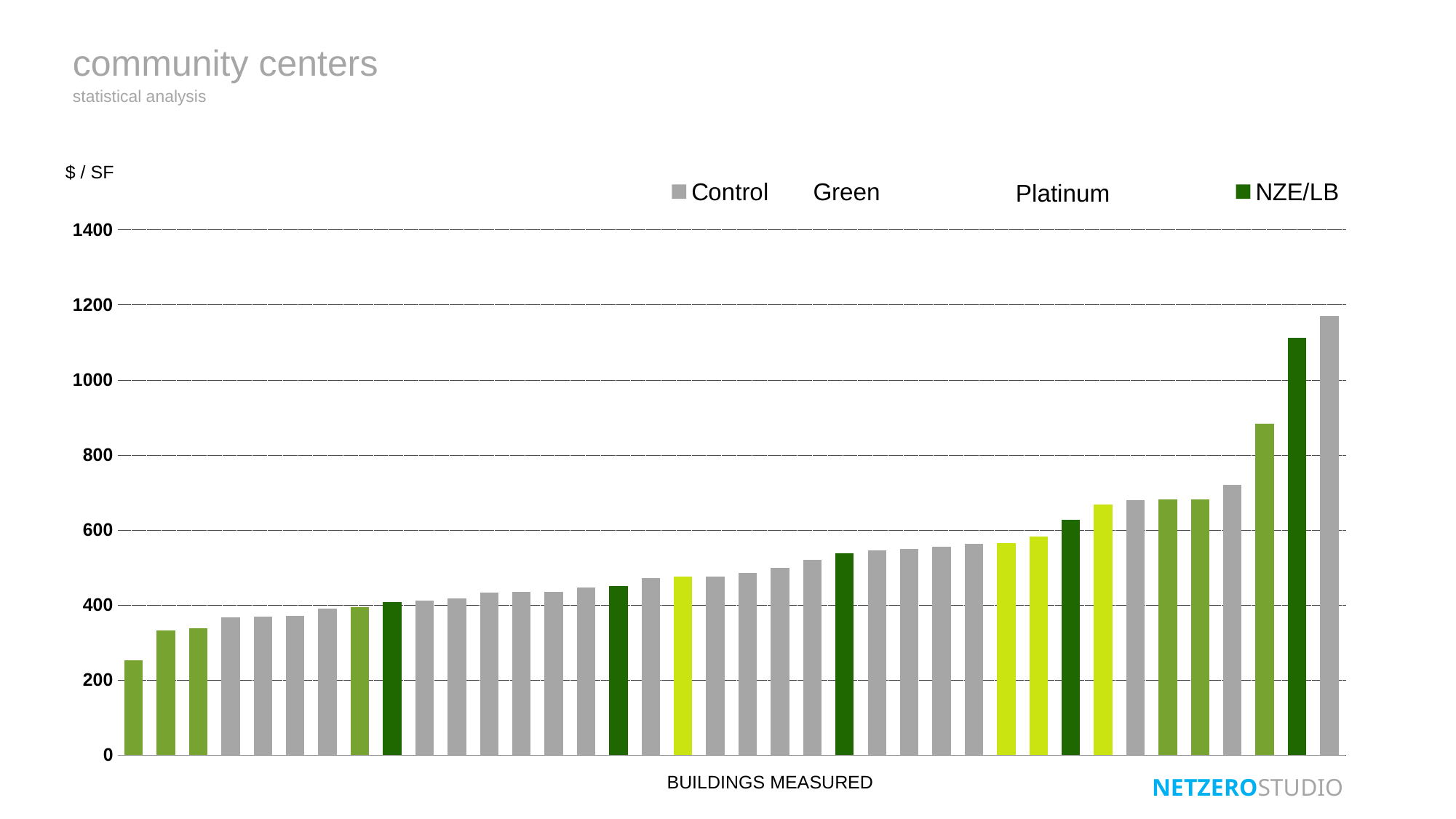
Which is larger: the rightmost bar or the bar immediately to its left? the rightmost bar Do the bar values generally rise or fall from left to right along the x axis? rise Which legend series does the tallest bar in the chart belong to? Control What is the label on the x axis of the chart? BUILDINGS MEASURED What is the label on the y axis of the chart? $ / SF How many series does the legend list? 4 Is the value of the leftmost bar greater or less than 400? less What kind of chart is shown on the slide? bar chart Is the value of the rightmost (tallest) bar greater or less than 1000? greater Is the value of the tallest NZE/LB (dark green) bar greater or less than 1000? greater How many bars (buildings measured) are plotted in the chart? 38